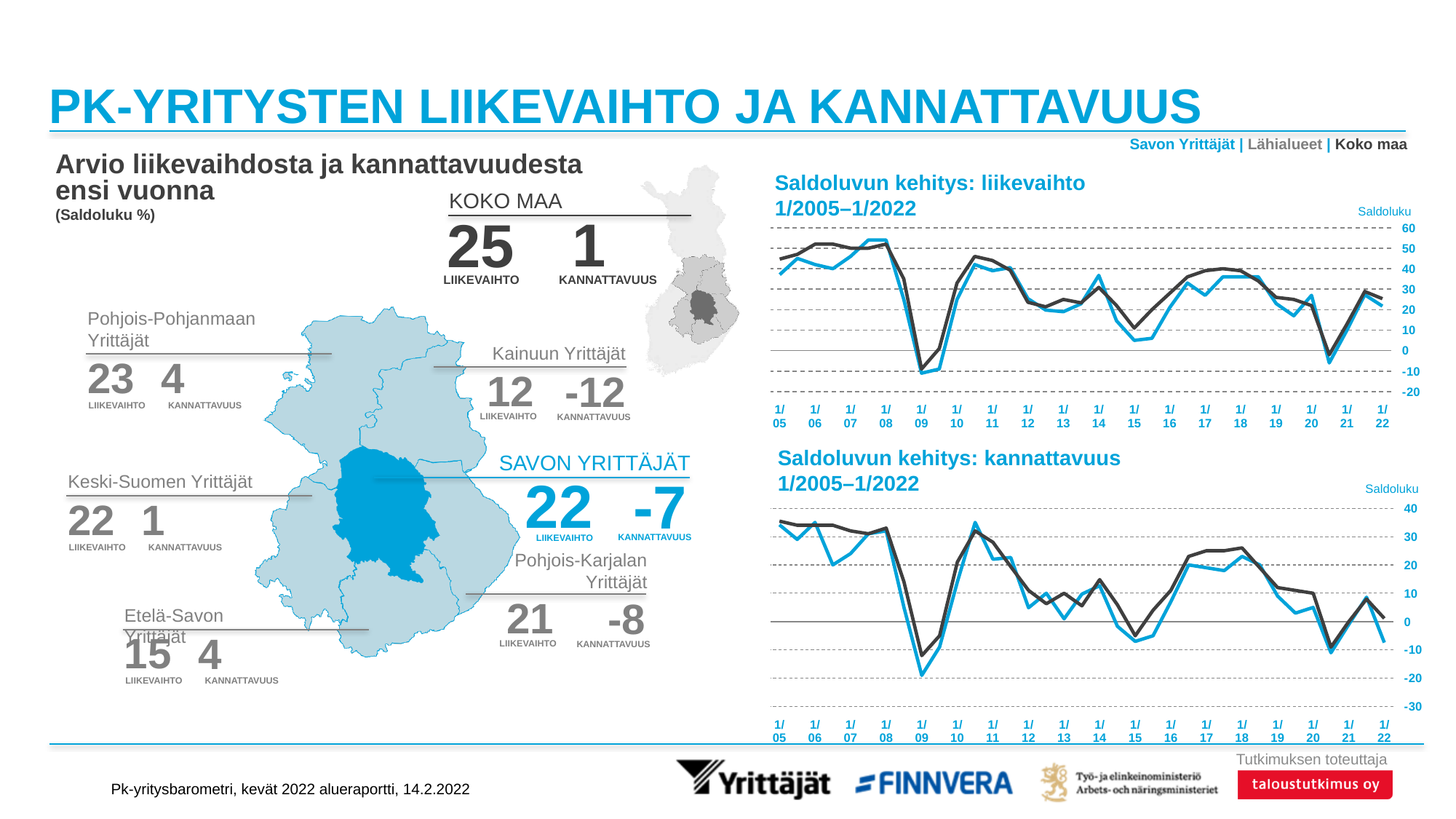
In the 'Saldoluvun kehitys: liikevaihto' chart, which series has the higher value at 1/15, Savon Yrittäjät or Koko maa? Koko maa In the 'Saldoluvun kehitys: liikevaihto' chart, is the Koko maa value at 1/08 greater or less than 40? greater How many time points are shown on the x axis of the 'Saldoluvun kehitys: kannattavuus 1/2005–1/2022' chart? 18 What kind of chart is the 'Saldoluvun kehitys: liikevaihto 1/2005–1/2022' chart? line chart What label is shown on the y axis of the 'Saldoluvun kehitys: liikevaihto' chart? Saldoluku In the 'Saldoluvun kehitys: kannattavuus' chart, at which time point does the Savon Yrittäjät line reach its lowest value? 1/09 In the 'Saldoluvun kehitys: kannattavuus' chart, is the Savon Yrittäjät value at 1/09 greater or less than -10? less In the 'Saldoluvun kehitys: liikevaihto' chart, is the Savon Yrittäjät value at 1/09 greater or less than 0? less In the 'Saldoluvun kehitys: liikevaihto' chart, does the Koko maa line rise or fall between 1/18 and 1/20? fall In the 'Saldoluvun kehitys: liikevaihto' chart, at which time point does the Savon Yrittäjät line reach its highest value? 1/08 In the 'Saldoluvun kehitys: liikevaihto' chart, at which time point does the Savon Yrittäjät line reach its lowest value? 1/09